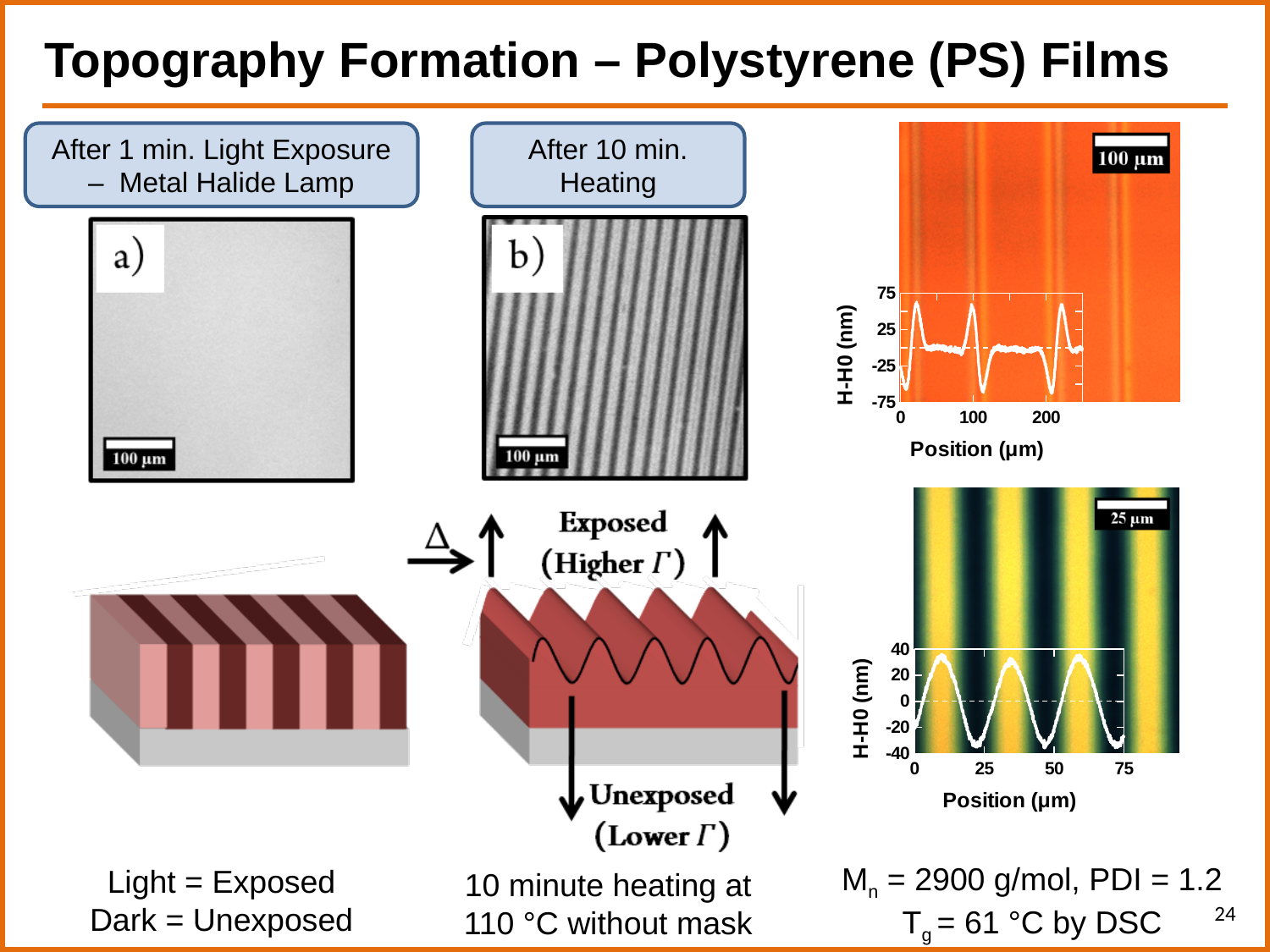
In the bottom-right chart, what is the label of the x axis? Position (µm) In the bottom-right chart, is the height of the peaks greater or less than 20 nm? greater In the bottom-right chart, what is the highest tick value shown on the x axis? 75 How many peaks does the profile in the bottom-right chart show? 3 What kind of chart is the bottom-right plot of H-H0 (nm) versus Position (µm)? line chart In the bottom-right chart, is the value at the troughs greater or less than -20 nm? less In the top-right chart, is the height of the peaks greater or less than 25 nm? greater How many data series are plotted in the bottom-right chart? 1 In the top-right chart, what is the label of the y axis? H-H0 (nm) What kind of chart is the top-right plot of H-H0 (nm) versus Position (µm)? line chart How many peaks does the profile in the top-right chart show? 3